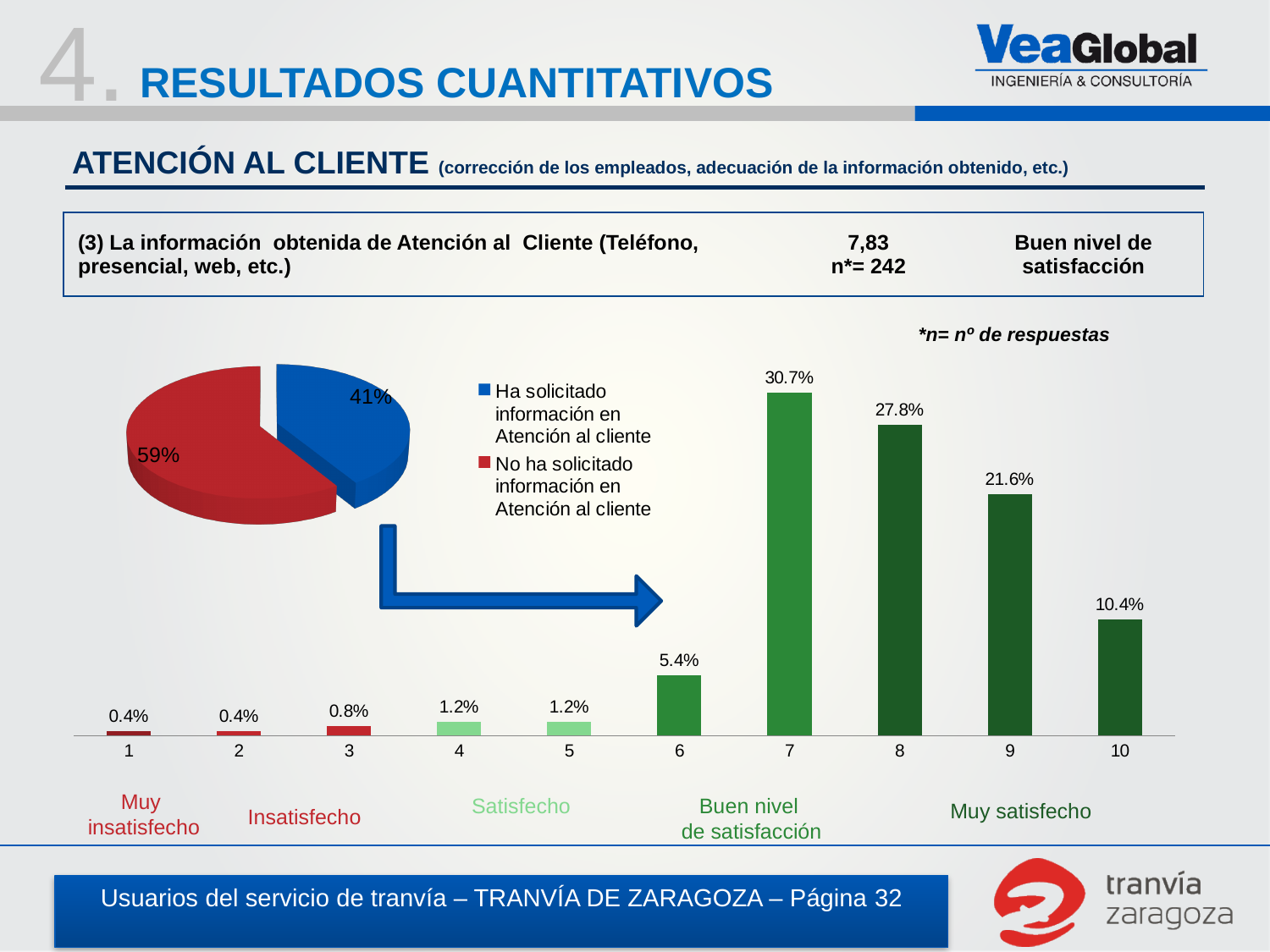
On the bar chart, what is the value for category 7? 30.7% On the pie chart, what colour is the 'Ha solicitado información en Atención al cliente' slice? Blue On the bar chart, how many categories are shown on the x axis? 10 On the bar chart, what is the difference between the values for categories 7 and 8? 2.9% On the pie chart, how many entries does the legend list? 2 On the bar chart, which category has the highest value? 7 On the pie chart, which slice is larger: 'Ha solicitado' or 'No ha solicitado'? No ha solicitado información en Atención al cliente On the pie chart, what share corresponds to 'Ha solicitado información en Atención al cliente'? 41% What kind of chart is the one on the right of the slide? Bar chart On the bar chart, which is larger: the value for category 9 or the value for category 10? 9 On the bar chart, what is the value for category 10? 10.4% On the pie chart, what share corresponds to 'No ha solicitado información en Atención al cliente'? 59%